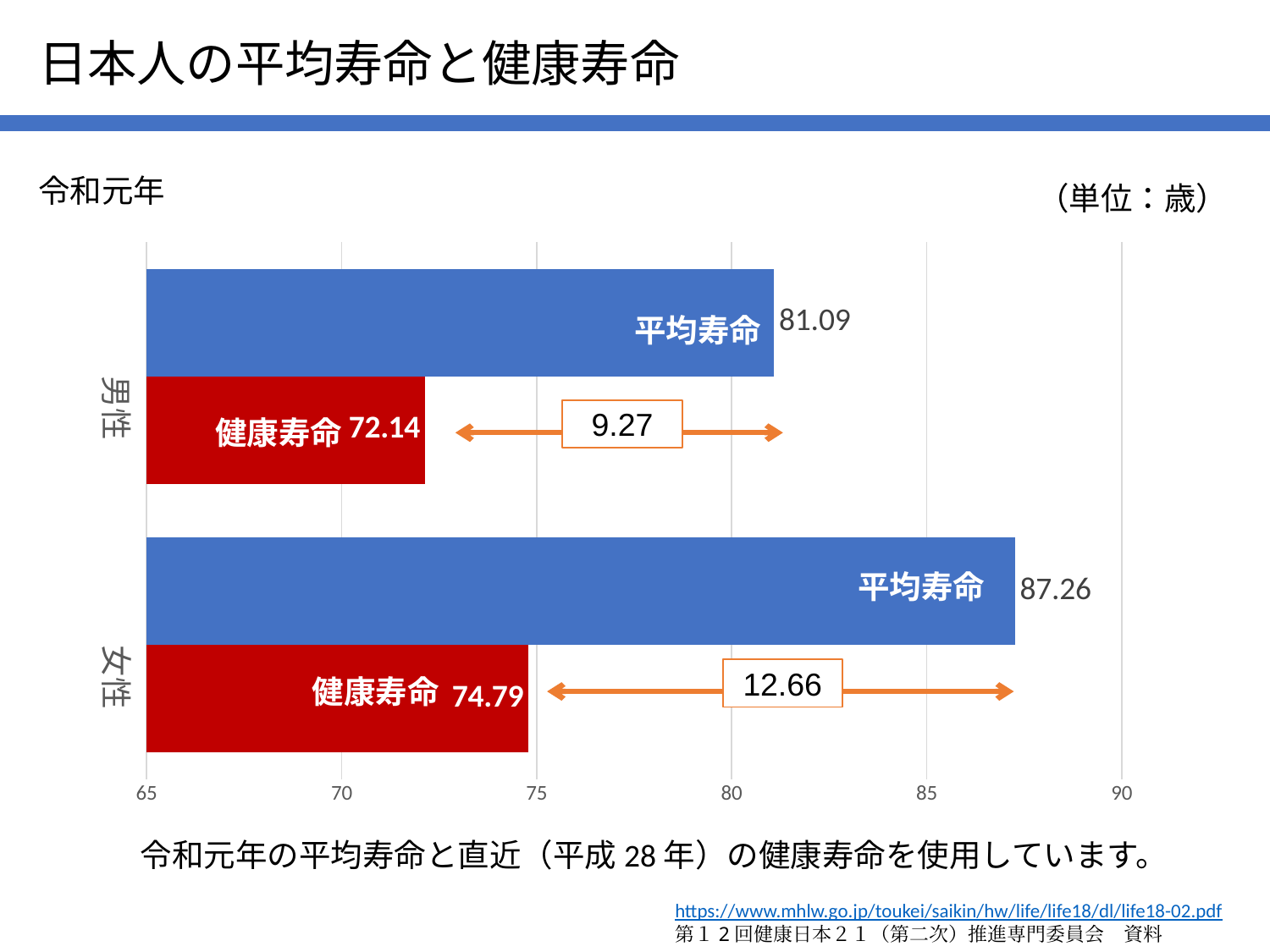
What is the 健康寿命 value for 女性? 74.79 Which category has the lowest 健康寿命 value? 男性 What is the 平均寿命 value for 男性? 81.09 Is the 平均寿命 value for 女性 greater or less than 85? greater What kind of chart is shown on the slide? bar chart What is the difference between 平均寿命 and 健康寿命 for 女性? 12.66 What is the 健康寿命 value for 男性? 72.14 What is the 平均寿命 value for 女性? 87.26 Which category has the highest 平均寿命 value? 女性 Which is larger: the 健康寿命 for 女性 or the 健康寿命 for 男性? 女性 What is the difference between 平均寿命 and 健康寿命 for 男性? 9.27 How many categories are shown on the chart? 2